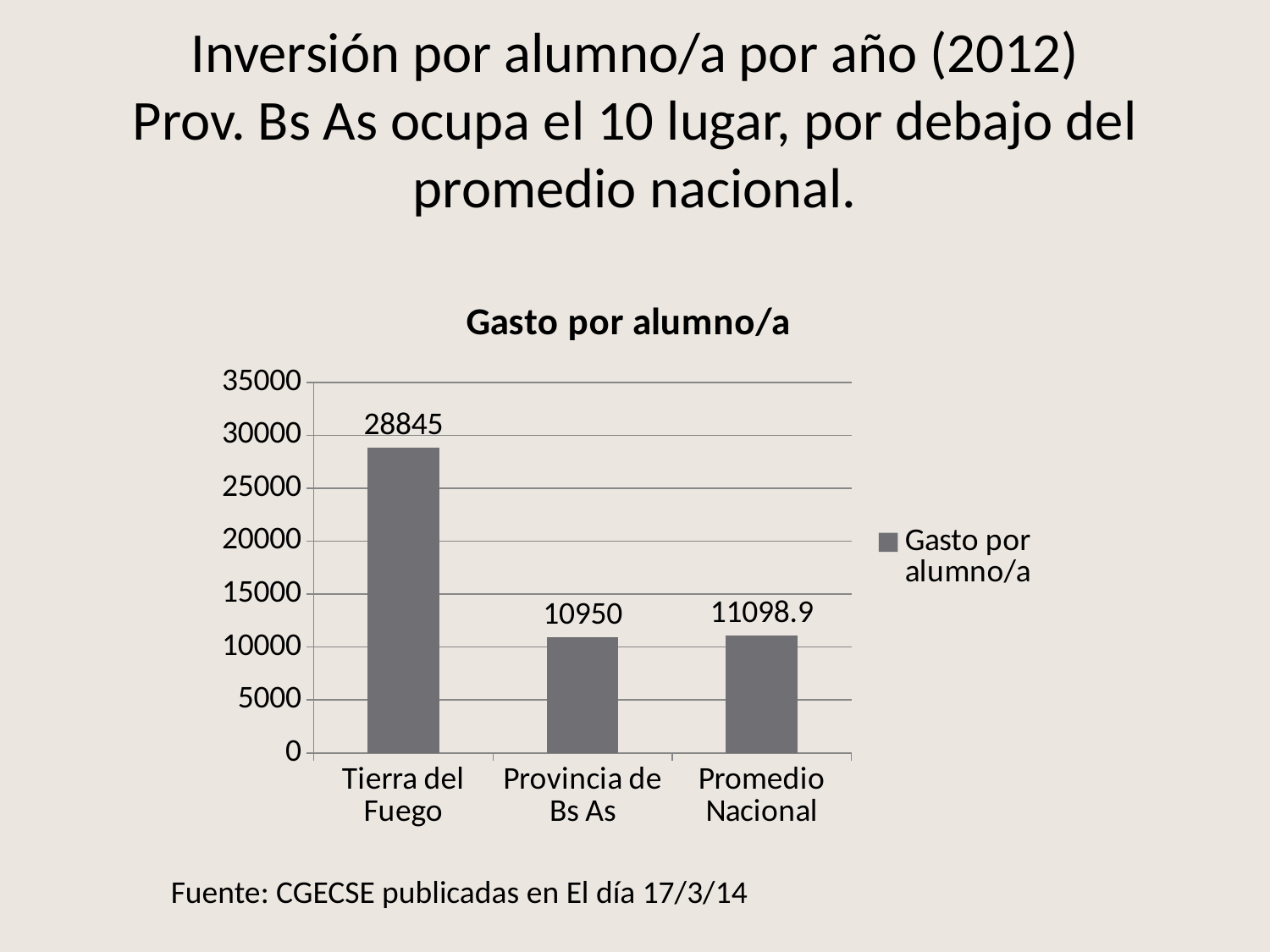
What is the value for Provincia de Bs As? 10950 What is the value for Tierra del Fuego? 28845 What is the title of the chart? Gasto por alumno/a Is the value for Tierra del Fuego greater or less than 25000? greater What is the difference between the values for Tierra del Fuego and Provincia de Bs As? 17895 What is the difference between the values for Promedio Nacional and Provincia de Bs As? 148.9 How many categories are shown on the x axis? 3 Which category has the lowest value? Provincia de Bs As What is the value for Promedio Nacional? 11098.9 Which is larger, the value for Tierra del Fuego or the value for Promedio Nacional? Tierra del Fuego Which category has the highest value? Tierra del Fuego What kind of chart is shown on the slide? bar chart